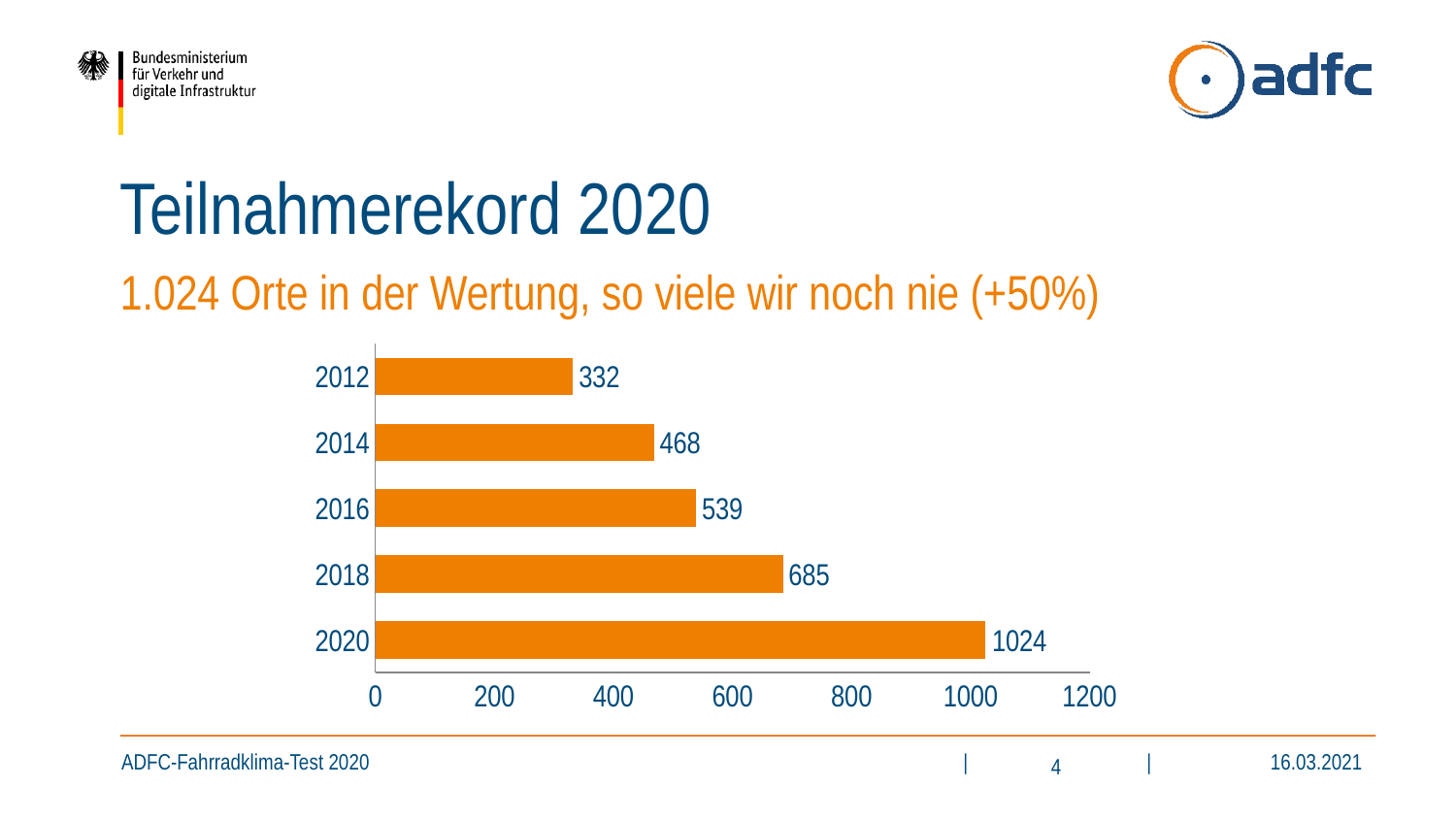
Which year has the highest value? 2020 What is the difference between the values for 2020 and 2018? 339 What is the value for 2020? 1024 How many years are shown in the chart? 5 Do the values rise or fall from 2012 to 2020? rise What is the value for 2012? 332 What is the difference between the values for 2014 and 2012? 136 Which is larger, the value for 2016 or the value for 2018? 2018 What kind of chart is shown on the slide? bar chart What is the value for 2016? 539 Is the value for 2014 greater or less than 400? greater Which year has the lowest value? 2012